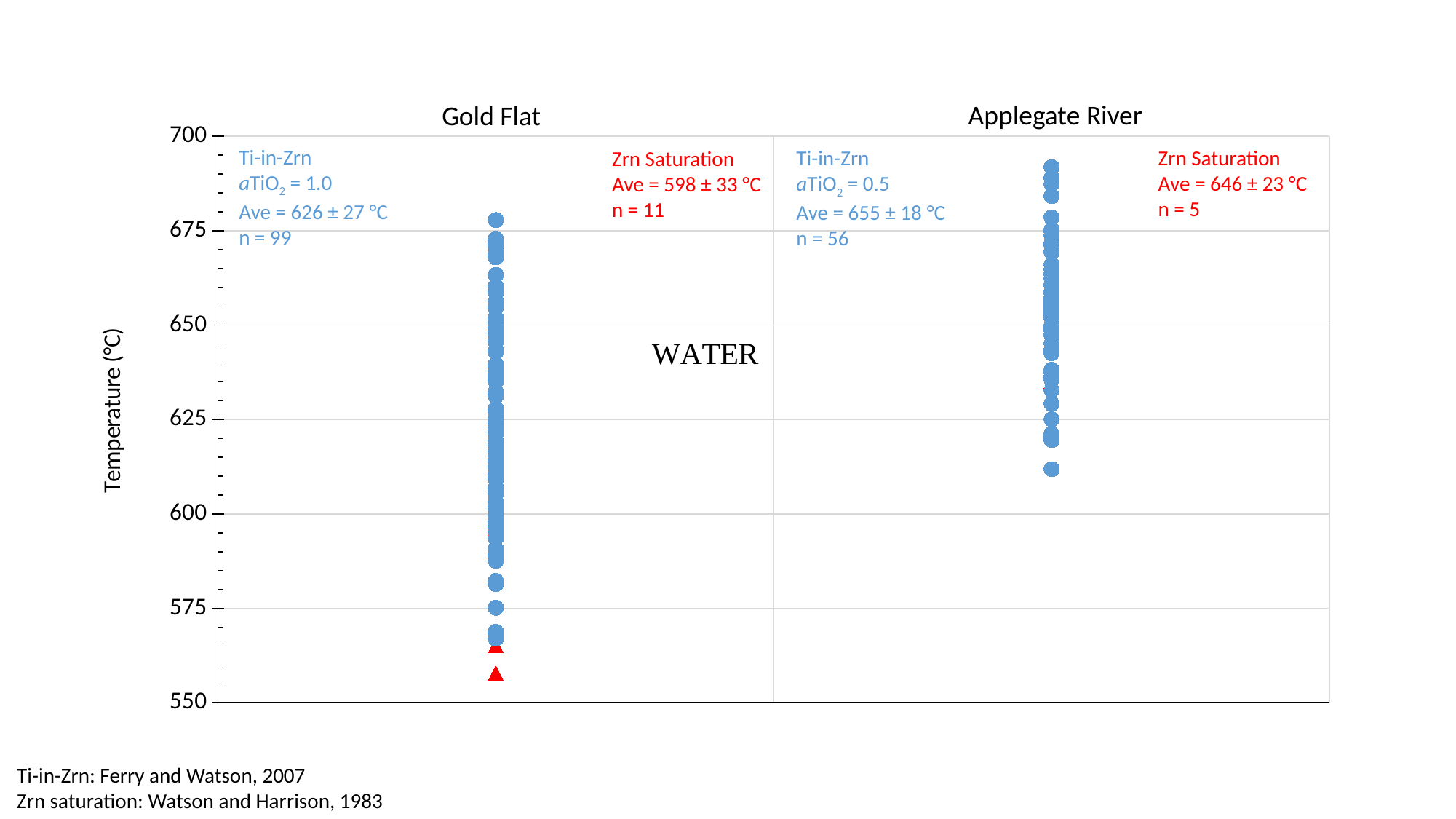
How many Ti-in-Zrn analyses (n) are reported for Gold Flat? 99 What is the Zrn Saturation average temperature for Applegate River? 646 ± 23 °C What is the Ti-in-Zrn average temperature for Applegate River? 655 ± 18 °C What is the difference between the Zrn Saturation average temperatures of Applegate River and Gold Flat? 48 °C How many Zrn Saturation analyses (n) are reported for Applegate River? 5 What is the difference between the Ti-in-Zrn average temperatures of Applegate River and Gold Flat? 29 °C What is the Zrn Saturation average temperature for Gold Flat? 598 ± 33 °C Which location has the higher Ti-in-Zrn average temperature, Gold Flat or Applegate River? Applegate River Is the lowest Ti-in-Zrn point for Applegate River greater or less than 625 °C? less What is the Ti-in-Zrn average temperature for Gold Flat? 626 ± 27 °C What is the label of the vertical axis? Temperature (°C) What kind of chart is shown on the slide? Scatter chart